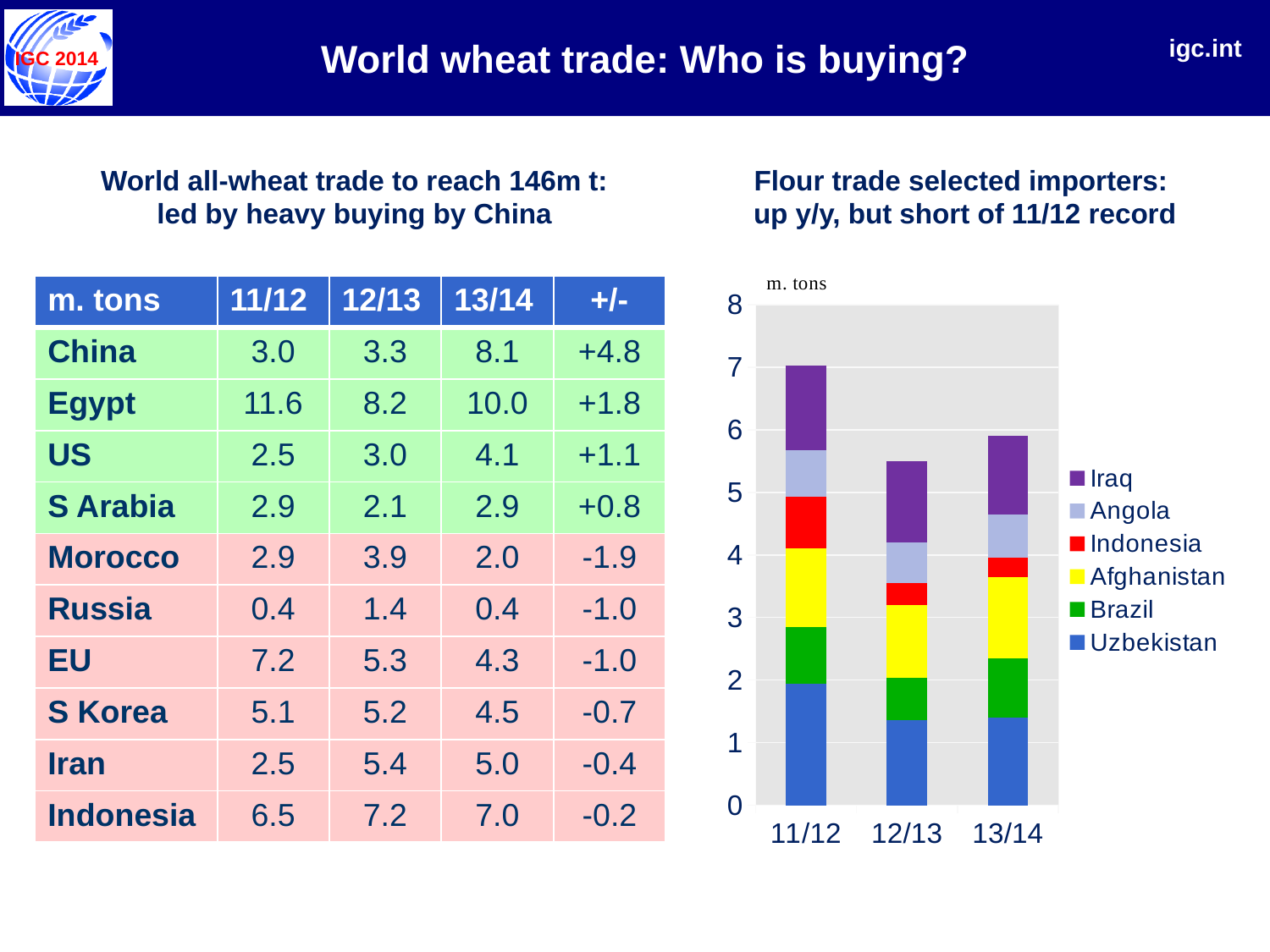
In the flour trade chart, is the Uzbekistan segment for 12/13 greater or less than 1? greater In the flour trade chart, is the total for 12/13 greater or less than 6? less In the flour trade chart, is the total for 11/12 greater or less than 6? greater In the flour trade chart, which season has the lowest total bar? 12/13 What kind of chart is shown on the right of the slide? Stacked bar chart How many seasons (bars) are shown on the x axis of the flour trade chart? 3 In the flour trade chart, does the total bar rise or fall from 11/12 to 12/13? fall In the flour trade chart, which season has the highest total bar? 11/12 Which importer is listed first (at the top) in the legend of the flour trade chart? Iraq How many series does the legend of the flour trade chart list? 6 In the flour trade chart, which total bar is larger, 11/12 or 13/14? 11/12